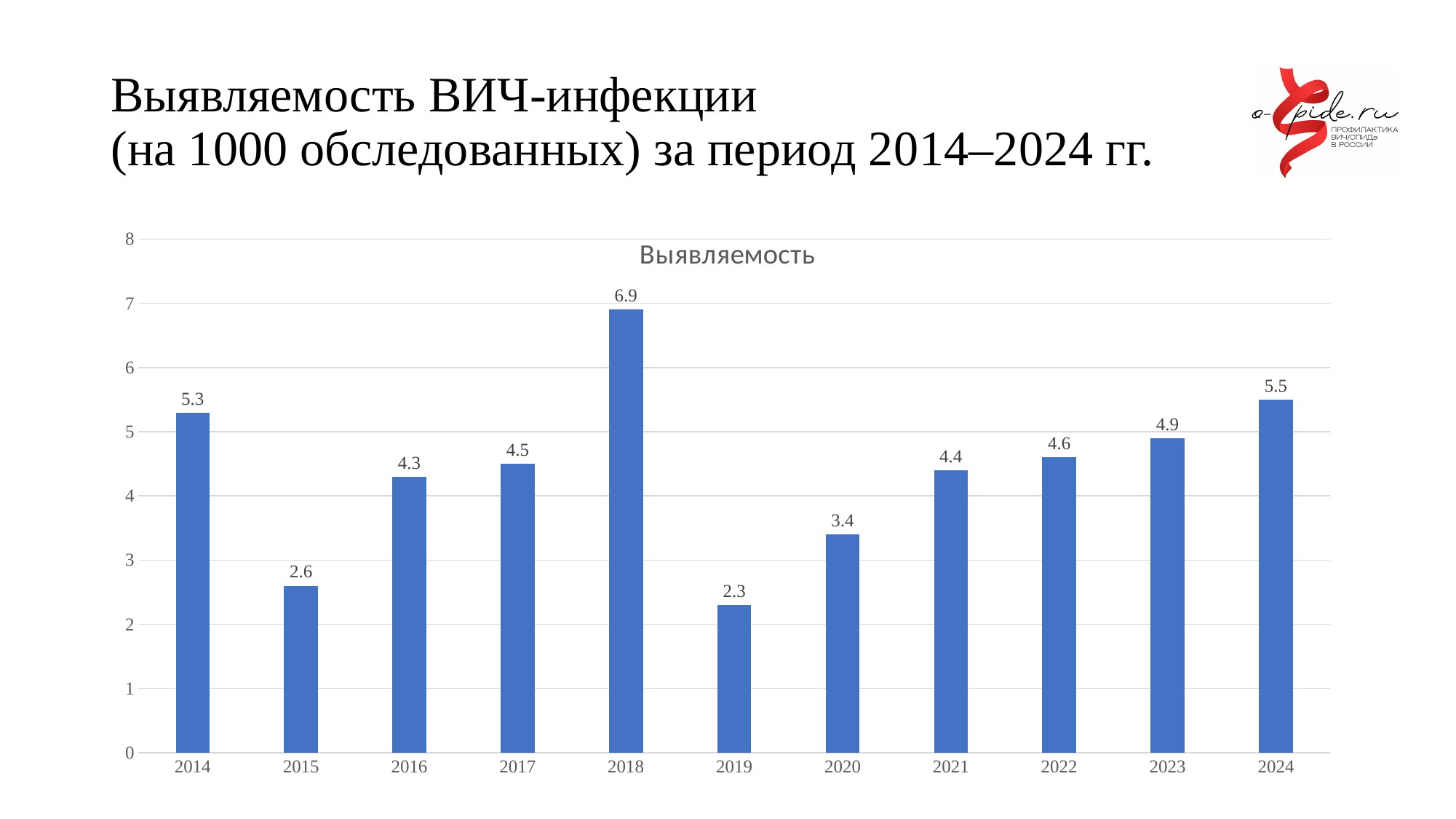
What is the title of the chart? Выявляемость Which year has the highest value? 2018 What is the difference between the values for 2018 and 2019? 4.6 What is the value for 2015? 2.6 Is the value for 2020 greater or less than 4? less What kind of chart is this? bar chart What is the value for 2018? 6.9 Do the values rise or fall from 2019 to 2024? rise Which is larger, the value for 2014 or the value for 2024? 2024 How many years are shown on the x axis? 11 Which year has the lowest value? 2019 What is the value for 2024? 5.5